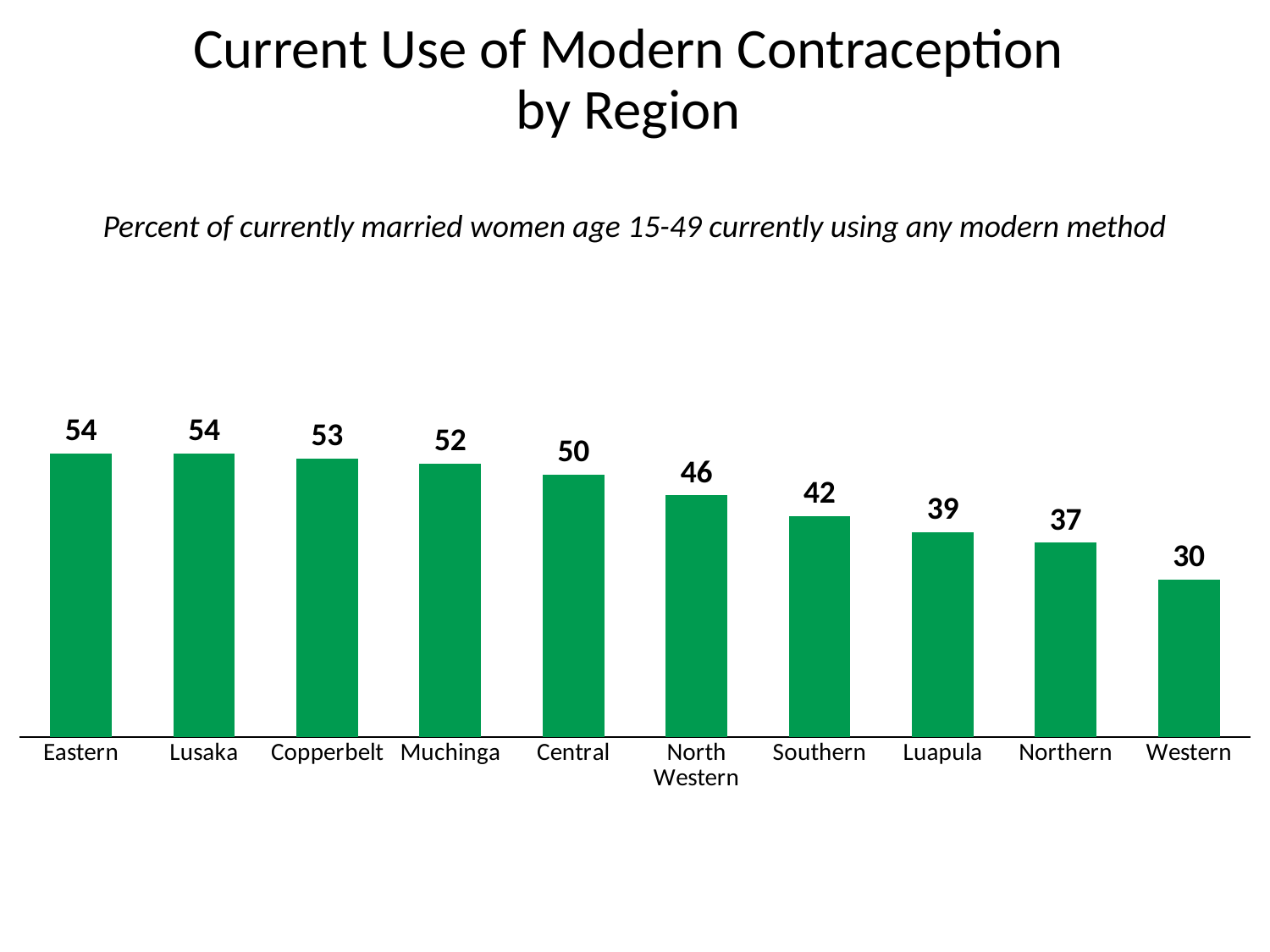
How many regions are shown in the chart? 10 What is the value for Central? 50 What kind of chart is shown on the slide? Bar chart Which region has the lowest value? Western What is the value for Luapula? 39 What is the value for Southern? 42 What is the difference between the values for Eastern and Western? 24 What is the title of the chart? Current Use of Modern Contraception by Region Do the values rise or fall from left to right across the regions? Fall What is the difference between the values for North Western and Northern? 9 Which is larger, the value for Muchinga or the value for Southern? Muchinga Which is larger, the value for Luapula or the value for North Western? North Western